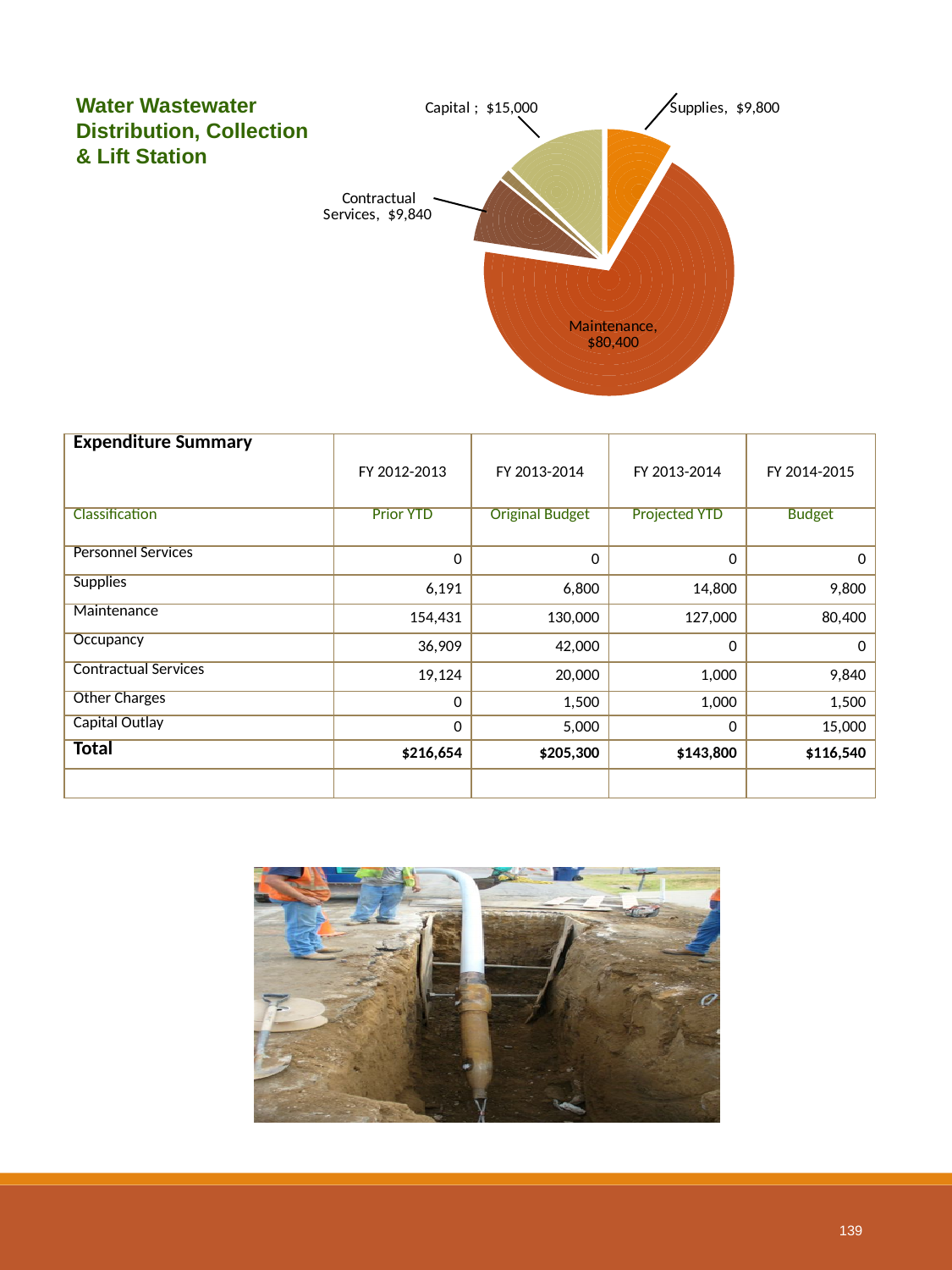
Which category has the largest slice in the pie chart? Maintenance What is the value of the Supplies slice in the pie chart? $9,800 What is the difference between the Capital and Contractual Services values in the pie chart? $5,160 What type of chart is shown on the slide? Pie chart What is the value of the Capital slice in the pie chart? $15,000 What is the difference between the Contractual Services and Supplies values in the pie chart? $40 Which is larger in the pie chart, Maintenance or Contractual Services? Maintenance Which is larger in the pie chart, Capital or Supplies? Capital What is the title shown next to the pie chart? Water Wastewater Distribution, Collection & Lift Station What is the value of the Maintenance slice in the pie chart? $80,400 What is the value of the Contractual Services slice in the pie chart? $9,840 What is the difference between the Maintenance and Capital values in the pie chart? $65,400